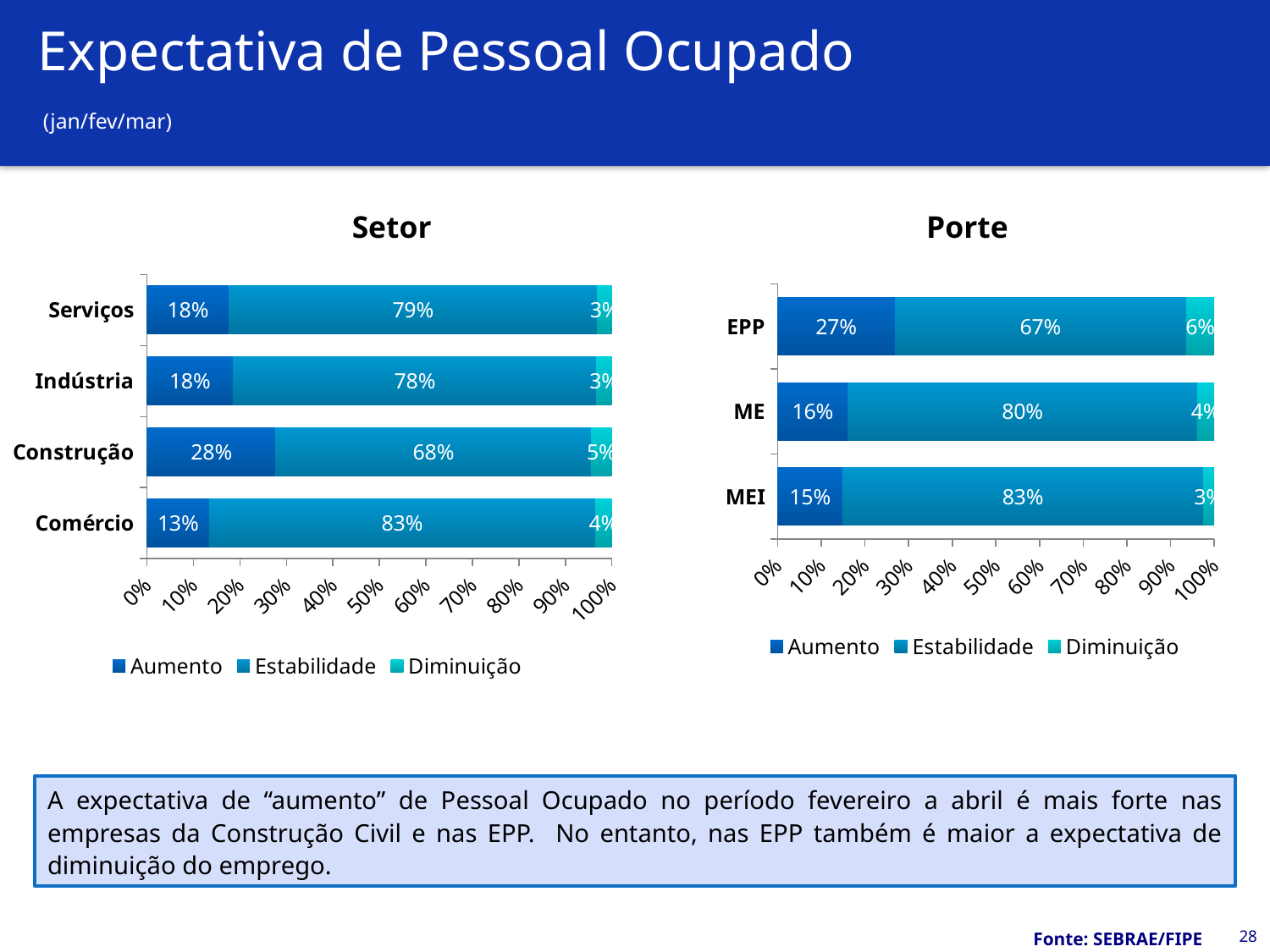
In the "Setor" chart, what is the Aumento value for Construção? 28% What kind of chart is the "Setor" chart? Stacked bar chart In the "Setor" chart, what is the Estabilidade value for Comércio? 83% In the "Porte" chart, which category has the lowest Aumento value? MEI In the "Porte" chart, what is the Diminuição value for EPP? 6% In the "Setor" chart, what is the difference between the Estabilidade values for Comércio and Construção? 15% In the "Porte" chart, which is larger: the Aumento value for EPP or for MEI? EPP In the "Setor" chart, which category has the highest Aumento value? Construção In the "Porte" chart, what is the total of the stacked bar for MEI? 101% How many categories does the "Setor" chart show? 4 How many series does the legend of the "Porte" chart list? 3 In the "Porte" chart, what is the Aumento value for ME? 16%